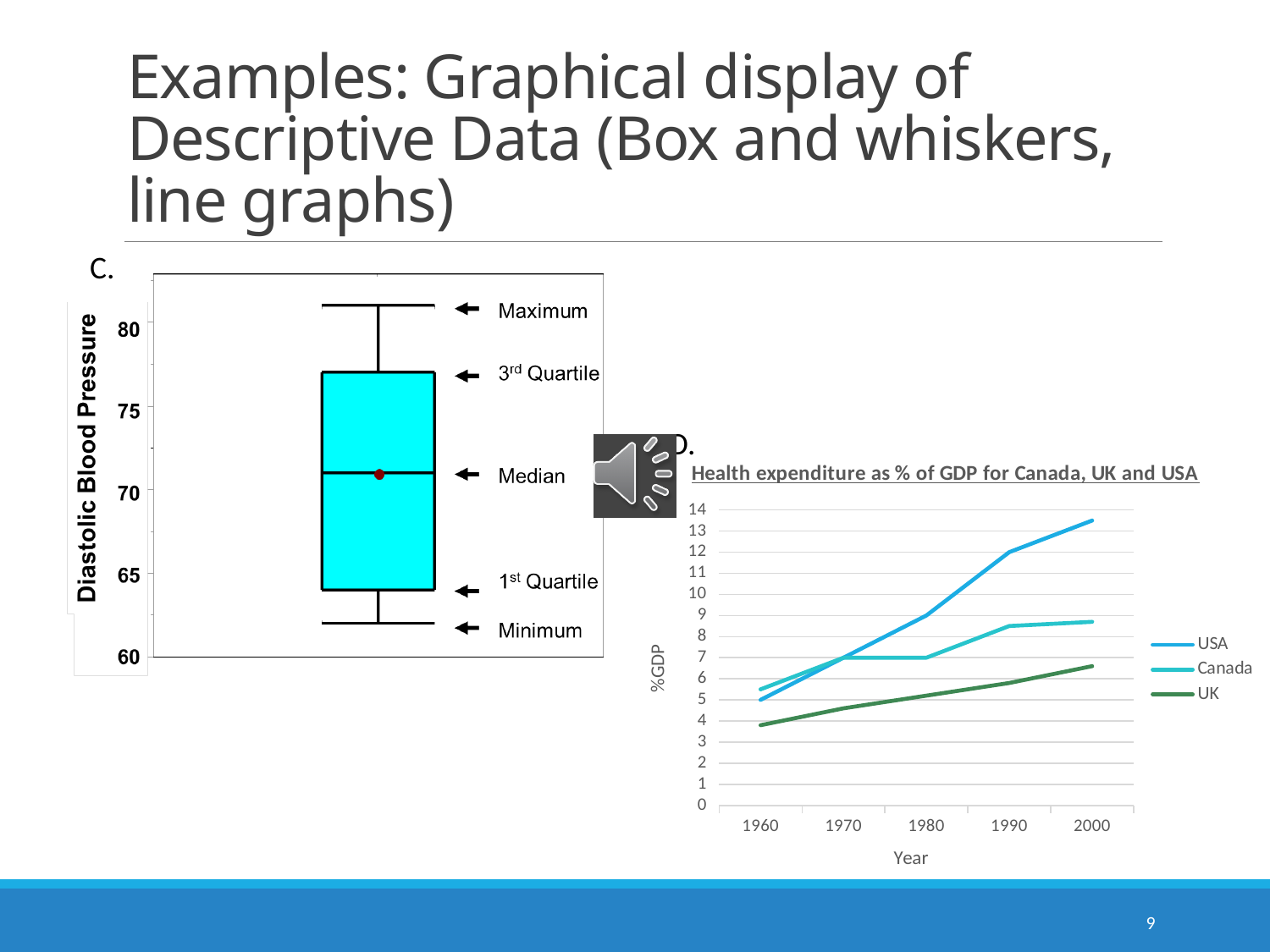
In chart C, is the minimum of the diastolic blood pressure data greater or less than 65? less In chart D, which country has the highest health expenditure as % of GDP in 2000? USA In chart D, how many series does the legend list? 3 What kind of chart is chart C, the one labelled 'Diastolic Blood Pressure'? Box and whisker plot In chart D, is the value for the UK in 2000 greater or less than 7? less In chart D, how many years are marked along the x axis? 5 In chart D, which is larger in 1980, the value for Canada or the value for the UK? Canada In chart D, what is the label on the x axis? Year In chart D, is the value for the USA in 1990 greater or less than 11? greater What kind of chart is chart D, 'Health expenditure as % of GDP for Canada, UK and USA'? Line chart In chart D, which country has the lowest health expenditure as % of GDP in 1960? UK In chart D, does the USA line rise or fall from 1960 to 2000? Rise